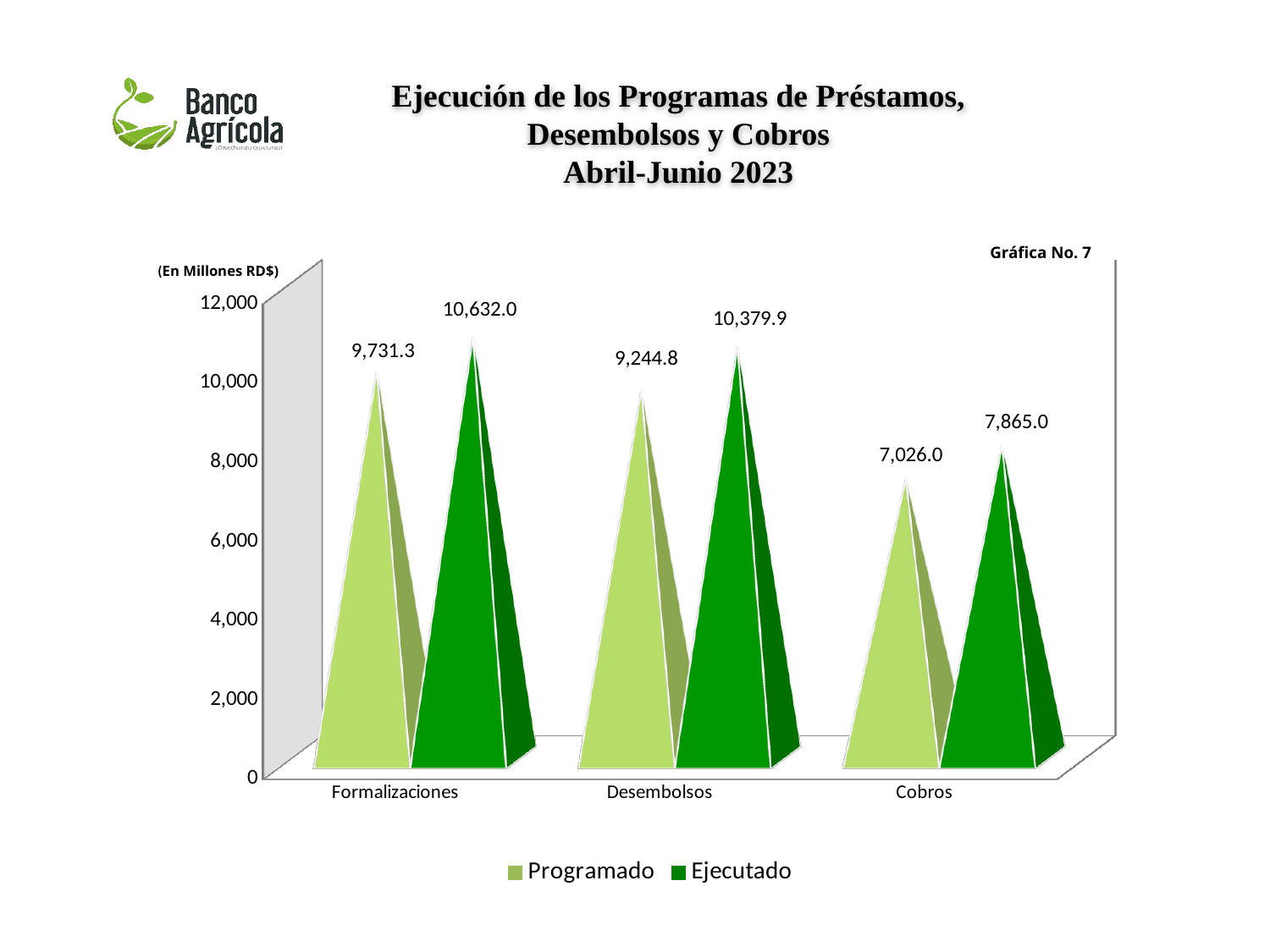
Which is larger for Formalizaciones, the Programado or the Ejecutado value? Ejecutado What is the difference between the Ejecutado and Programado values for Desembolsos? 1,135.1 Which category has the lowest Programado value? Cobros How many categories are shown on the x axis? 3 What is the Ejecutado value for Formalizaciones? 10,632.0 Is the Ejecutado value for Cobros greater or less than 8,000? less What is the difference between the Ejecutado and Programado values for Cobros? 839.0 What unit is stated for the values in the chart? En Millones RD$ Which category has the highest Ejecutado value? Formalizaciones How many series does the legend list? 2 What is the Programado value for Cobros? 7,026.0 What is the Programado value for Desembolsos? 9,244.8